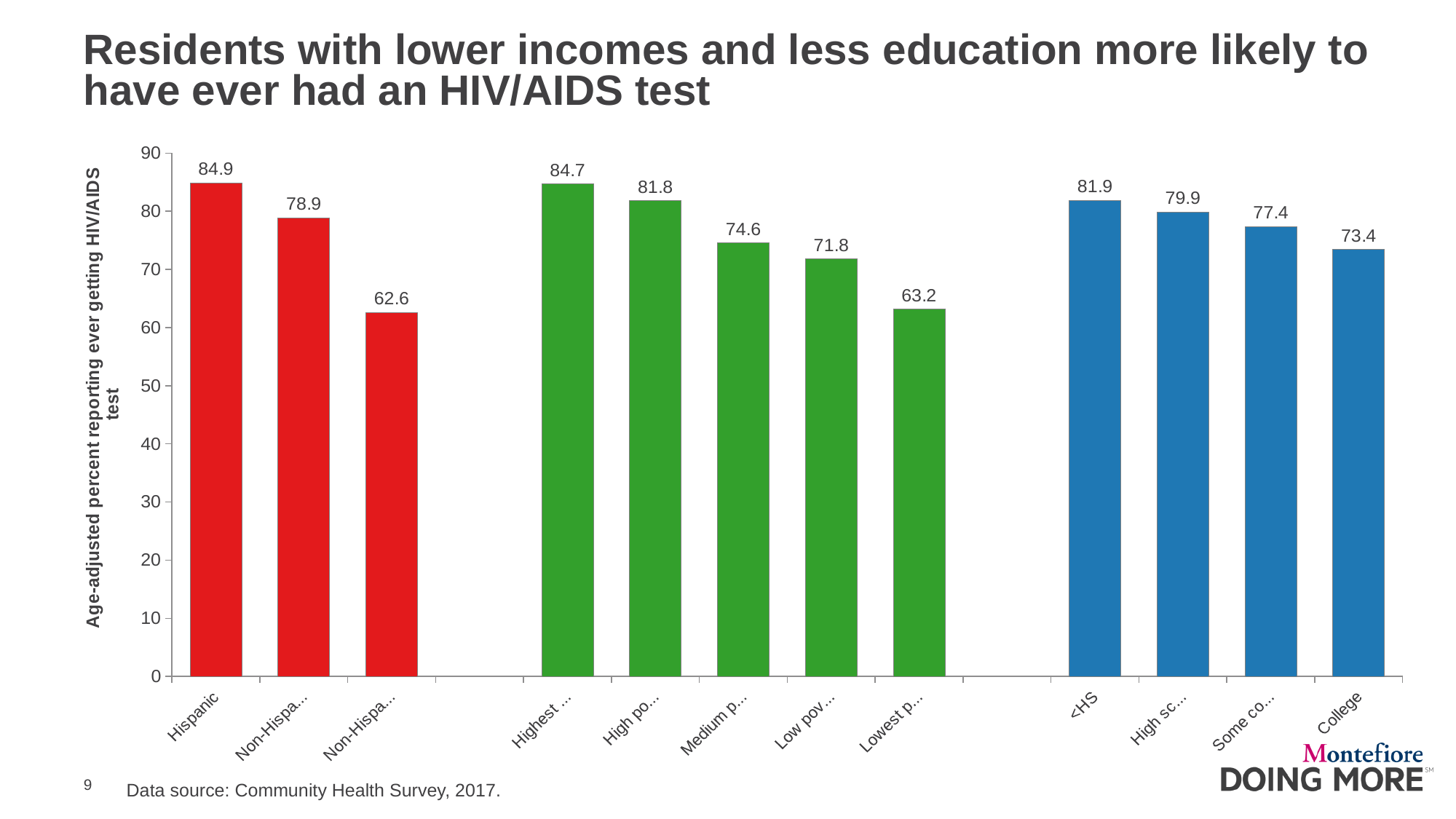
What is the difference between the values for <HS and College? 8.5 What is the value for College? 73.4 Which is larger, the value for Hispanic or the value for <HS? Hispanic Do the values of the blue bars rise or fall from <HS to College? fall Is the value for College greater or less than 70? greater How many bars are shown in the chart? 12 Which category has the highest value in the chart? Hispanic What kind of chart is shown on the slide? bar chart What is the value for <HS? 81.9 What is the value for Hispanic? 84.9 What is the difference between the values for Hispanic and College? 11.5 What is the lowest value shown on the chart? 62.6